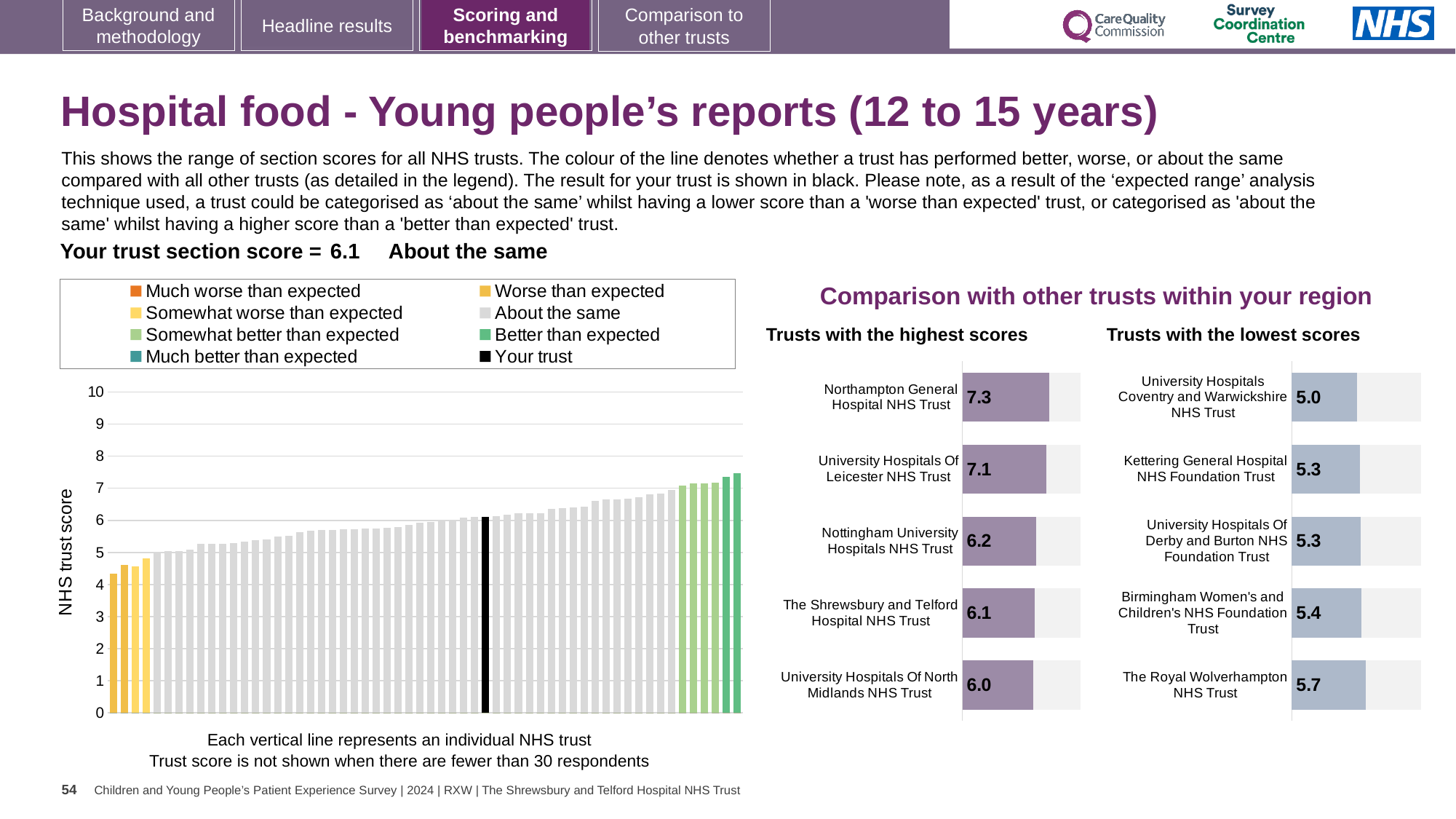
In the 'Trusts with the highest scores' chart, what is the difference between the scores of Northampton General Hospital NHS Trust and University Hospitals Of North Midlands NHS Trust? 1.3 In the 'Trusts with the lowest scores' chart, what is the difference between the scores of The Royal Wolverhampton NHS Trust and University Hospitals Coventry and Warwickshire NHS Trust? 0.7 In the NHS trust score chart on the left, do the bar values rise or fall from left to right? rise In the 'Trusts with the highest scores' chart, which trust has the highest score? Northampton General Hospital NHS Trust In the 'Trusts with the lowest scores' chart, what is the score for The Royal Wolverhampton NHS Trust? 5.7 In the 'Trusts with the highest scores' chart, which has the larger score: University Hospitals Of Leicester NHS Trust or Nottingham University Hospitals NHS Trust? University Hospitals Of Leicester NHS Trust In the 'Trusts with the lowest scores' chart, which trust has the lowest score? University Hospitals Coventry and Warwickshire NHS Trust In the NHS trust score chart on the left, is the value of the black bar (your trust) greater or less than 5? greater How many trusts are listed in the 'Trusts with the lowest scores' chart? 5 In the 'Trusts with the highest scores' chart, what is the score for Northampton General Hospital NHS Trust? 7.3 How many entries does the legend of the NHS trust score chart on the left list? 8 In the 'Trusts with the highest scores' chart, what is the score for University Hospitals Of North Midlands NHS Trust? 6.0